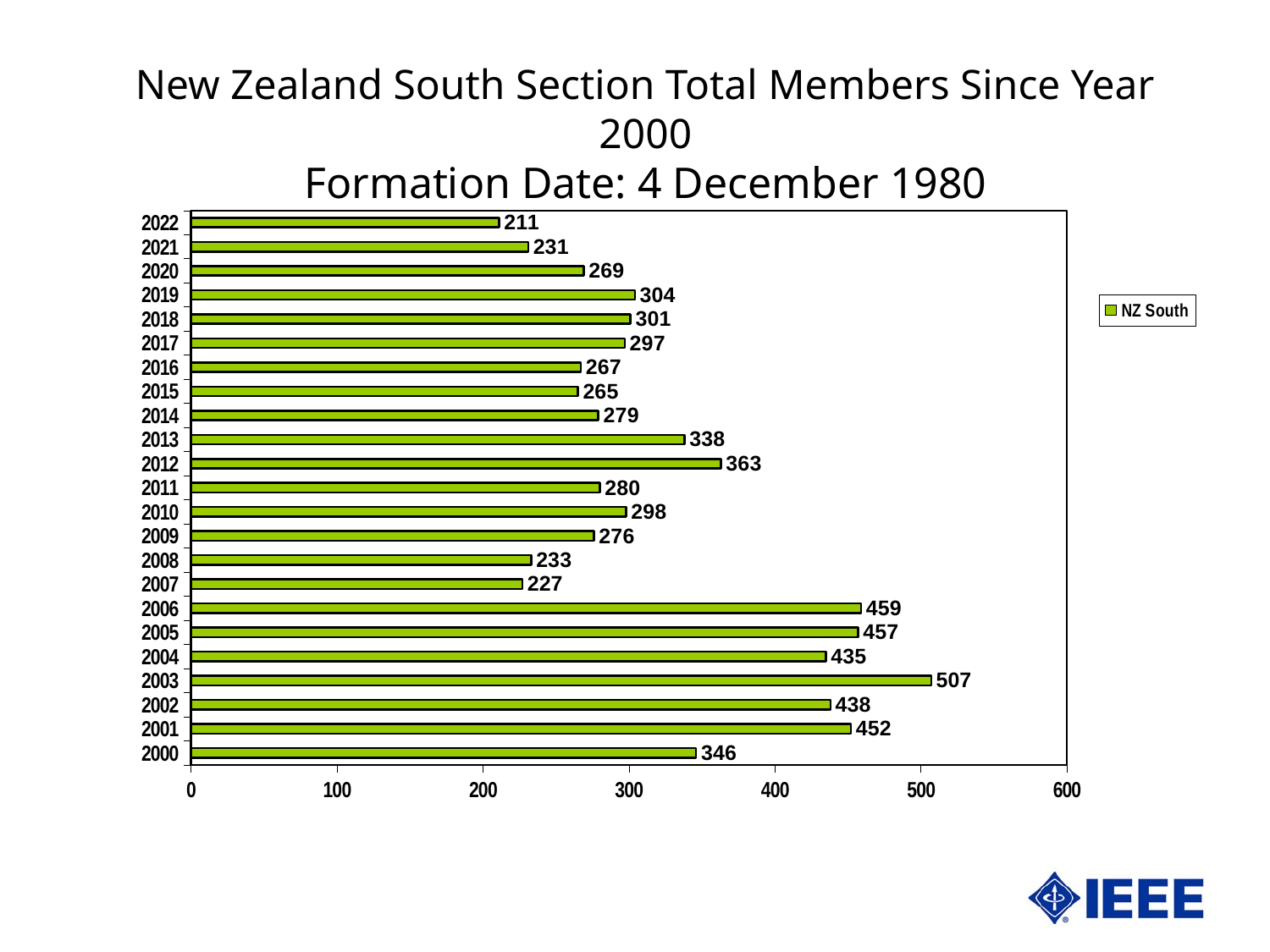
What is the name of the series in the legend? NZ South How many series does the legend list? 1 What is the difference between the values for 2003 and 2000? 161 What is the value for 2012? 363 What is the value for 2003? 507 Is the value for 2013 greater or less than 300? greater What kind of chart is shown? bar chart How many years are shown on the chart? 23 Which is larger, the value for 2006 or the value for 2005? 2006 Which year has the lowest value? 2022 What is the value for 2022? 211 Which year has the highest value? 2003